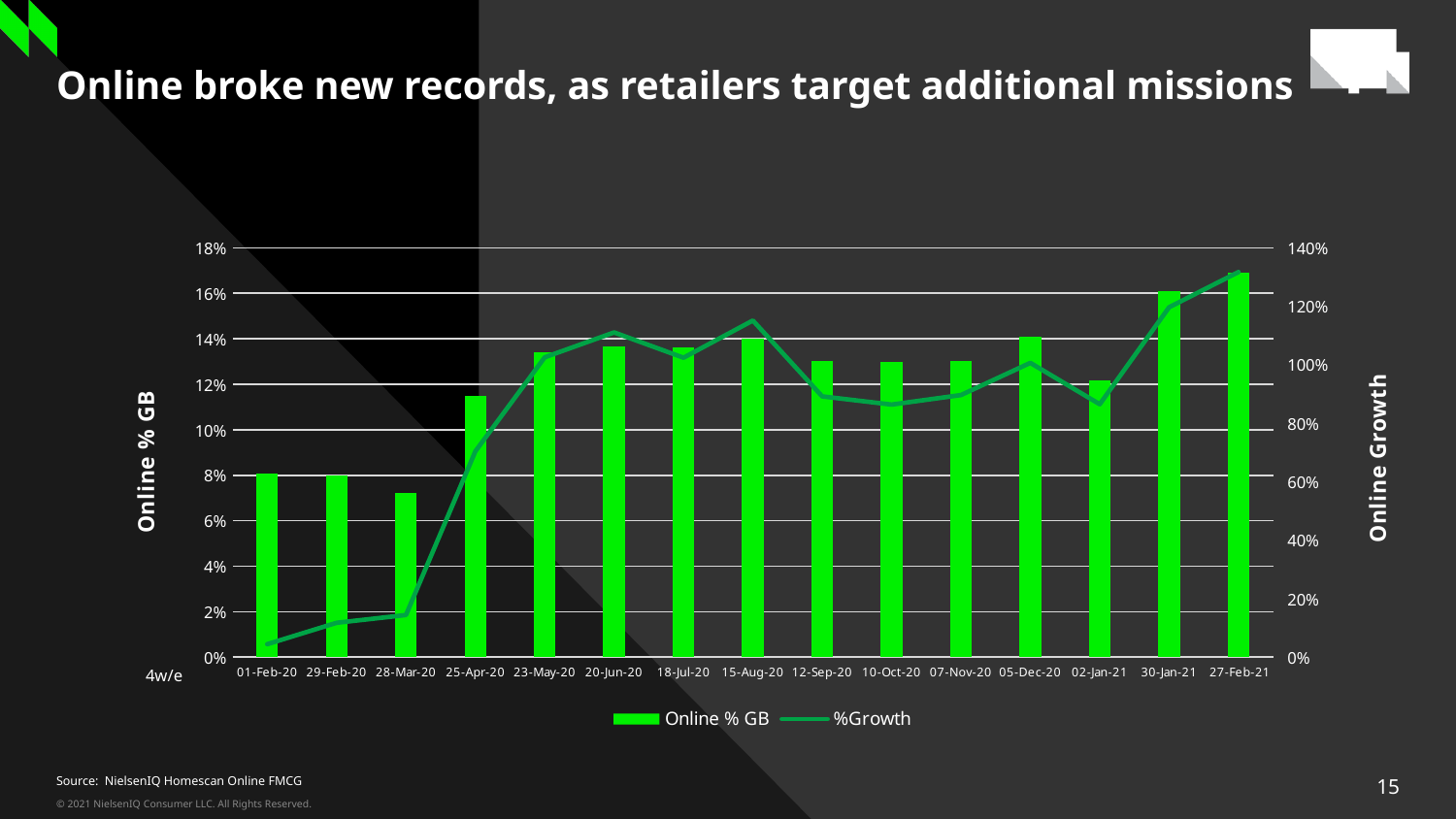
Which has the larger Online % GB value, 15-Aug-20 or 02-Jan-21? 15-Aug-20 Which period has the lowest Online % GB bar? 28-Mar-20 What kind of chart is shown on the slide? A combined bar and line chart How many 4-week periods are shown on the x axis? 15 Is the %Growth value for 01-Feb-20 greater or less than 20%? less How many series does the legend list? 2 Does the Online % GB series generally rise or fall from 01-Feb-20 to 27-Feb-21? Rise Is the Online % GB value for 28-Mar-20 greater or less than 8%? less Is the %Growth value for 27-Feb-21 greater or less than 120%? greater What is the label of the right-hand vertical axis? Online Growth Which period has the highest Online % GB bar? 27-Feb-21